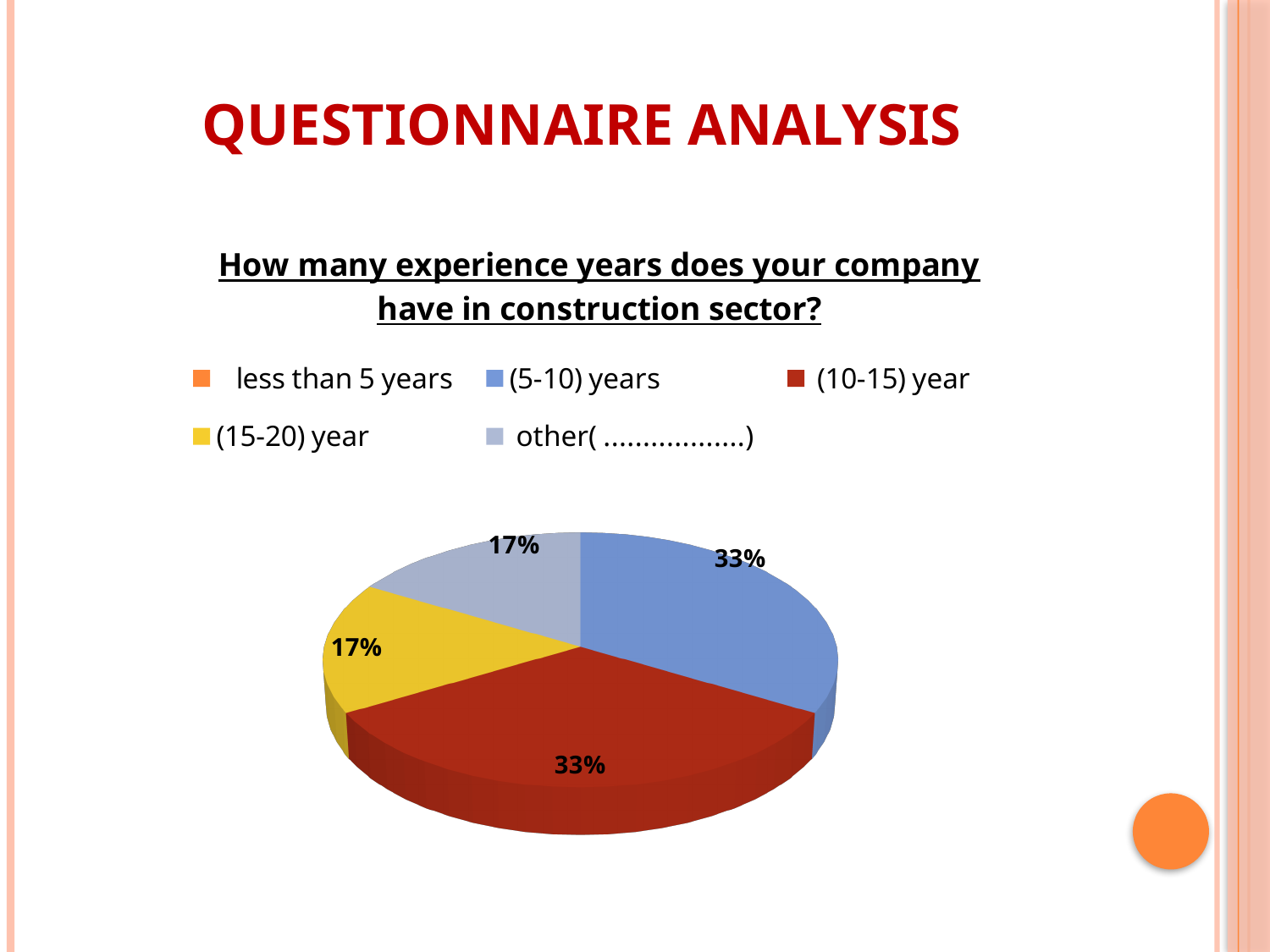
How many slices with data labels are visible in the pie? 4 What colour is the (10-15) year slice? red What share of the pie is the other( ..................) slice? 17% What share of the pie is the (10-15) year slice? 33% What kind of chart is shown on the slide? pie chart What is the difference between the (5-10) years share and the other( ..................) share? 16% Is the share for (15-20) year greater or less than 25%? less Which is larger, the (10-15) year slice or the (15-20) year slice? (10-15) year What is the chart's title? How many experience years does your company have in construction sector? How many categories does the legend list? 5 What share of the pie is the (15-20) year slice? 17%